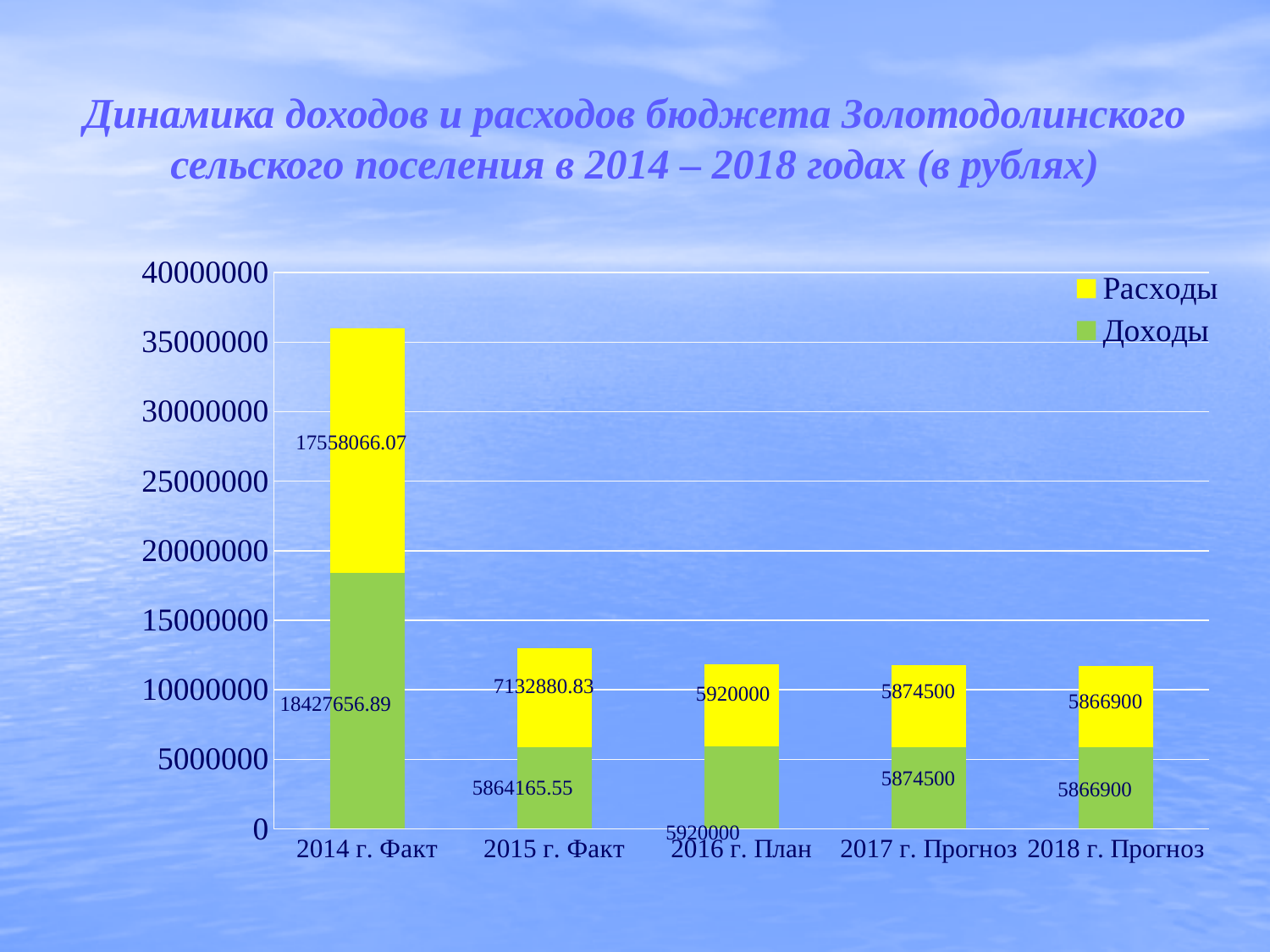
How many categories are shown on the x axis? 5 Which category has the highest Доходы value? 2014 г. Факт What type of chart is shown on the slide? Stacked bar chart What is the value of Расходы for 2014 г. Факт? 17558066.07 What is the difference between Расходы and Доходы for 2015 г. Факт? 1268715.28 What is the total of the stacked bar for 2017 г. Прогноз? 11749000 How many series does the legend list? 2 What is the value of Доходы for 2014 г. Факт? 18427656.89 Which category has the lowest Доходы value? 2015 г. Факт What is the value of Доходы for 2016 г. План? 5920000 What is the value of Расходы for 2018 г. Прогноз? 5866900 What is the value of Расходы for 2015 г. Факт? 7132880.83